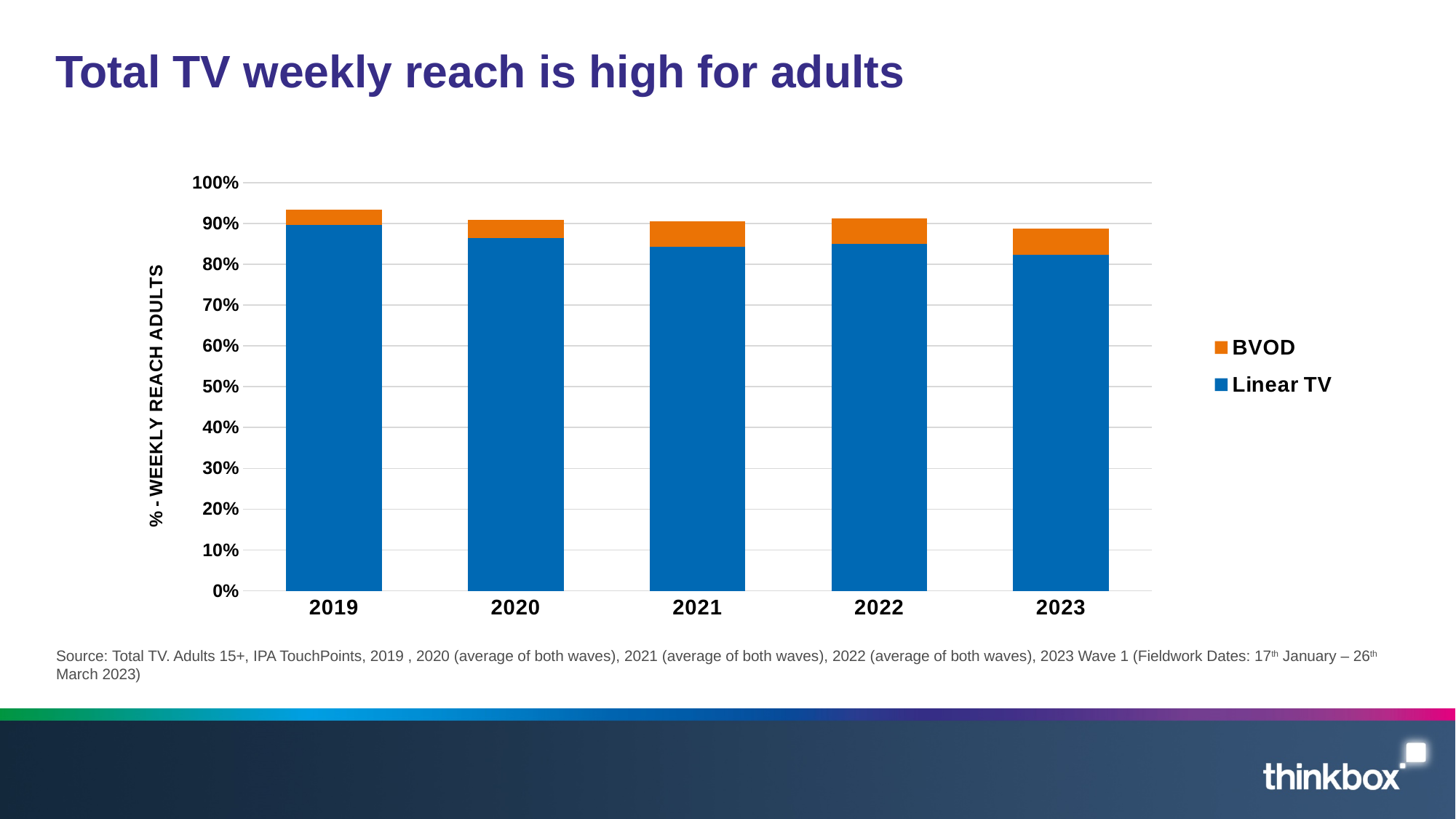
Is the Linear TV weekly reach in 2019 greater or less than 80%? greater Is the total height of the 2019 stacked bar greater or less than 90%? greater How many years are shown on the x axis of the chart? 5 Is the Linear TV weekly reach in 2023 greater or less than 90%? less In which year is the Linear TV weekly reach lowest? 2023 What is the label of the vertical axis? % - WEEKLY REACH ADULTS Does the Linear TV weekly reach generally rise or fall from 2019 to 2023? fall In which year is the Linear TV weekly reach highest? 2019 How many series does the chart's legend list? 2 Which year has the highest total TV weekly reach (Linear TV plus BVOD)? 2019 Which series are listed in the chart's legend? BVOD and Linear TV What kind of chart is shown on the slide? Stacked bar chart